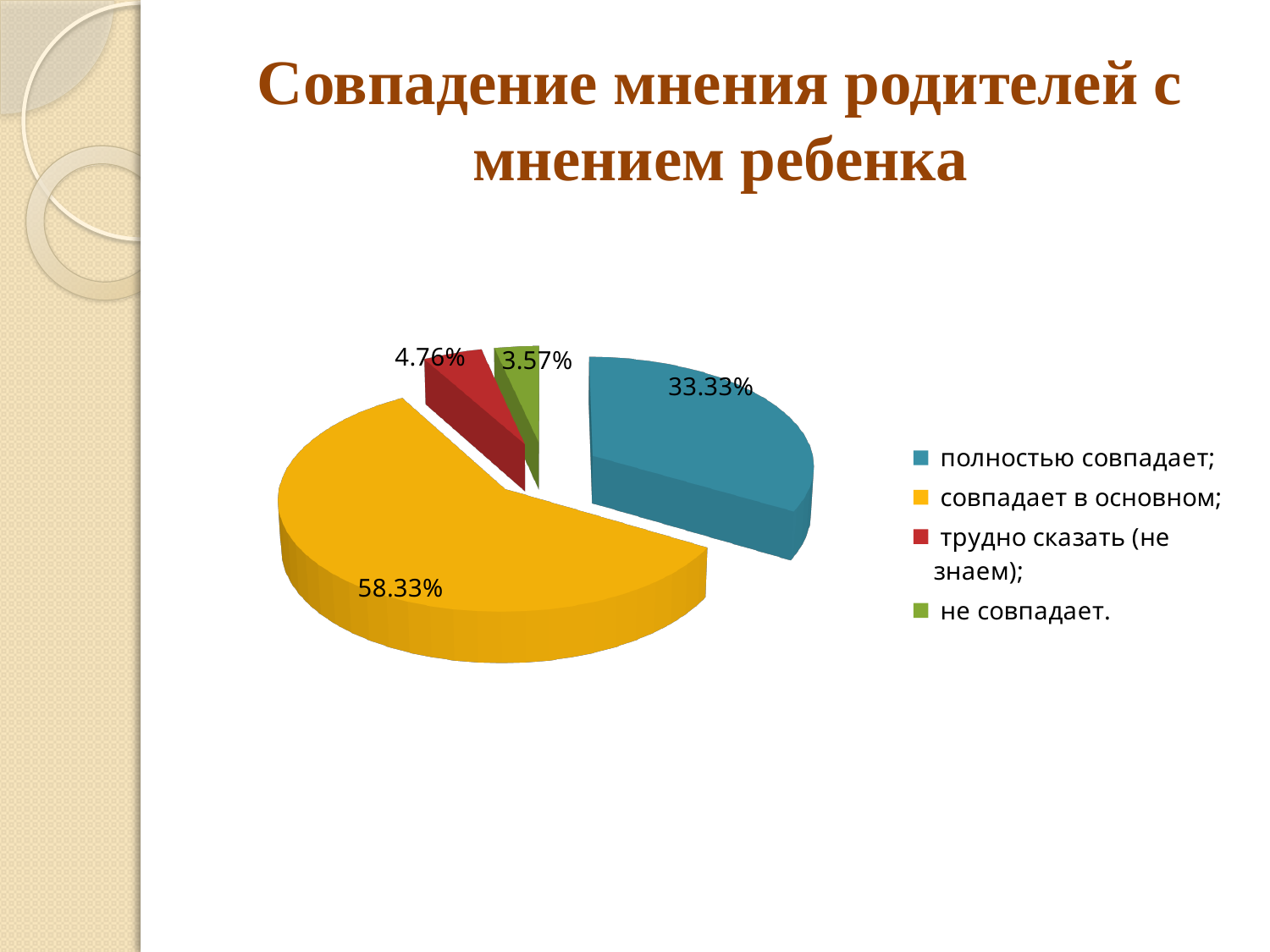
Which category has the largest slice of the pie? совпадает в основном What kind of chart is shown on the slide? pie chart What is the title of the slide containing the chart? Совпадение мнения родителей с мнением ребенка What share of the pie does "трудно сказать (не знаем)" have? 4.76% How many categories does the pie chart have? 4 What is the difference between the shares of "совпадает в основном" and "полностью совпадает"? 25% Which category has the smallest slice of the pie? не совпадает What colour is the slice for "полностью совпадает"? blue What share of the pie does "не совпадает" have? 3.57% What share of the pie does "совпадает в основном" have? 58.33% What share of the pie does "полностью совпадает" have? 33.33% Which is larger: the share of "трудно сказать (не знаем)" or the share of "не совпадает"? трудно сказать (не знаем)